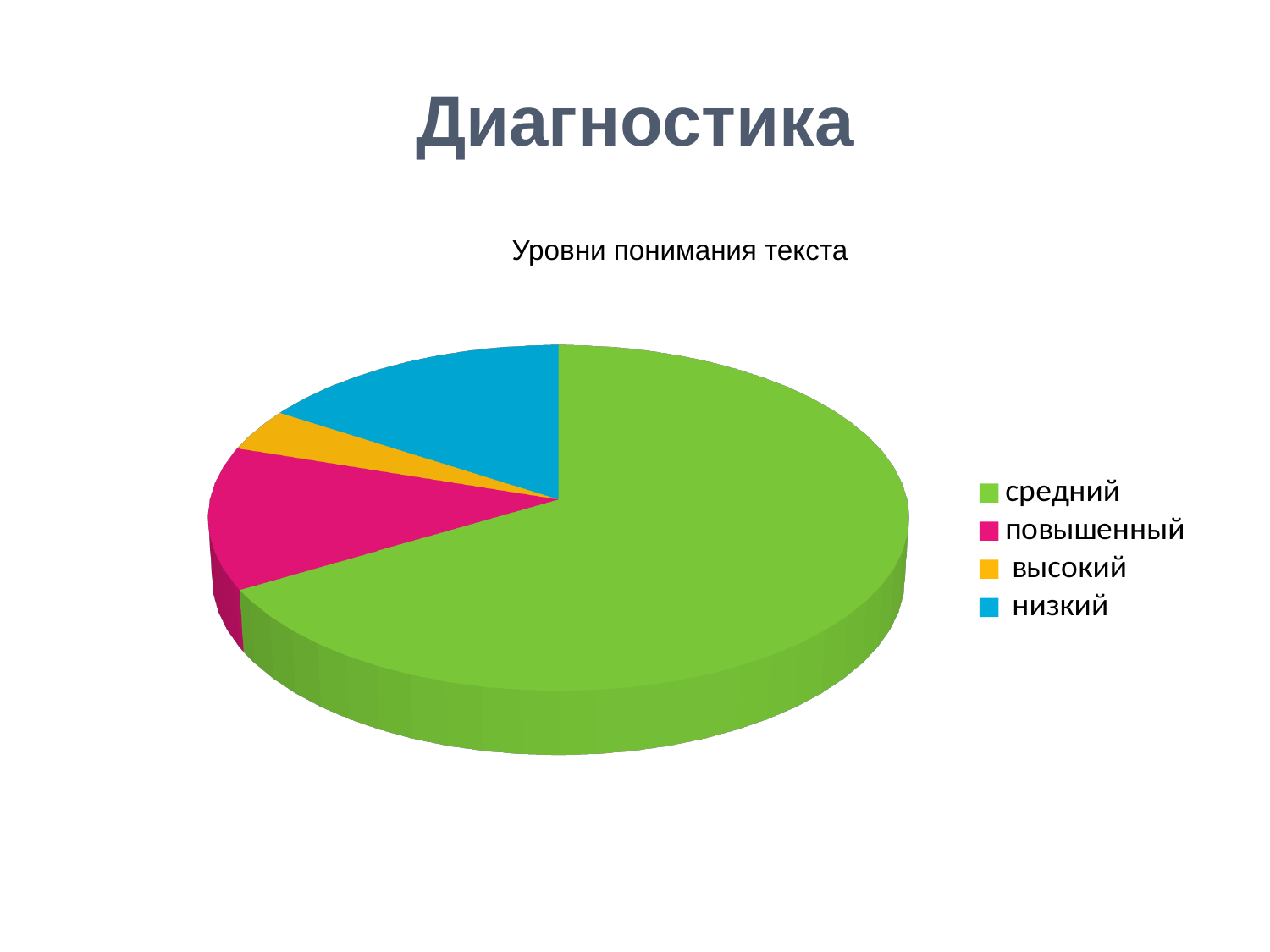
Which slice is larger, низкий or высокий? низкий What is the title of the chart? Уровни понимания текста Which category has the largest slice of the pie? средний Which slice is larger, повышенный or высокий? повышенный Which category has the smallest slice of the pie? высокий Which slice is larger, средний or низкий? средний What kind of chart is shown on the slide? pie chart How many categories does the pie chart have? 4 Which colour represents the category средний in the pie chart? green